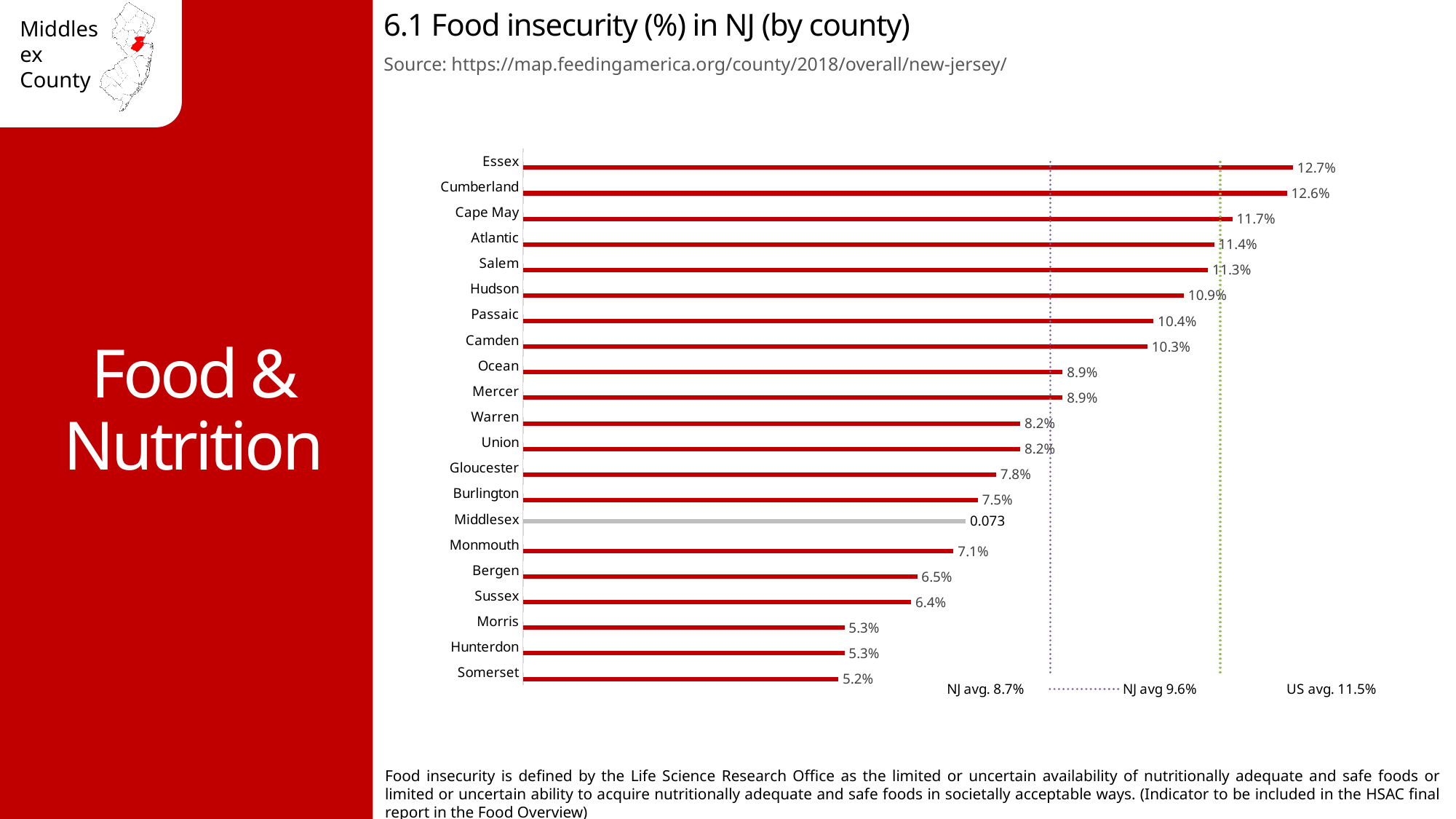
What is the food insecurity value shown for Hudson? 10.9% What is the food insecurity value shown for Essex? 12.7% Which has a higher food insecurity value, Passaic or Ocean? Passaic What kind of chart is used to show food insecurity by county? Bar chart What is the difference between the values for Camden and Bergen? 3.8% Which county has the highest food insecurity value? Essex What value is printed next to the Middlesex bar? 0.073 What is the difference between the values for Essex and Cumberland? 0.1% Which has a higher food insecurity value, Sussex or Monmouth? Monmouth Which county has the lowest food insecurity value? Somerset What US average value is labelled on the chart? 11.5% How many counties are shown in the chart? 21